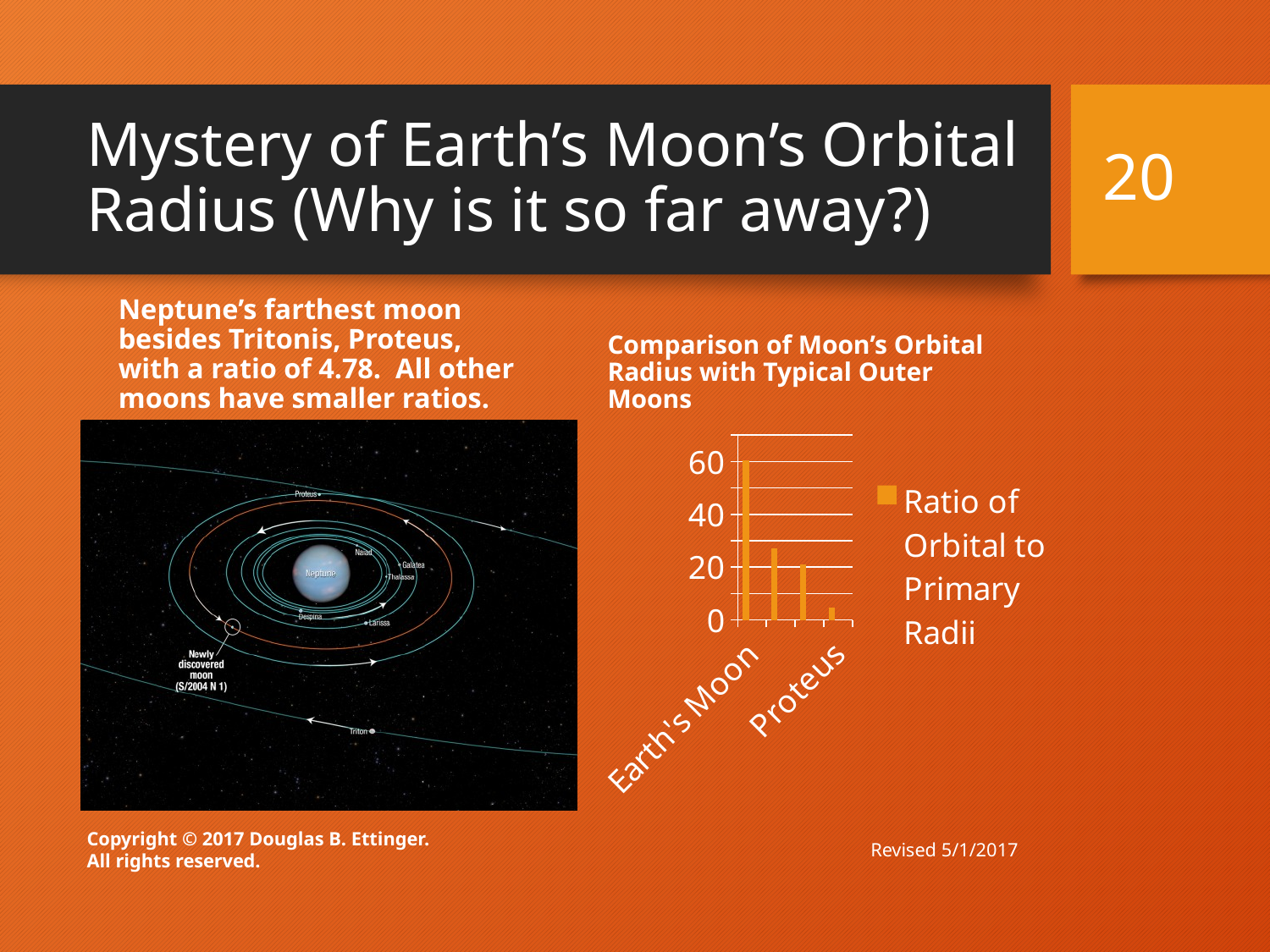
What is the name of the series shown in the chart's legend? Ratio of Orbital to Primary Radii Is the value for Proteus greater or less than 40? less Which category has the highest ratio of orbital to primary radii in the chart? Earth's Moon Do the bar values rise or fall moving from left to right along the x axis? fall How many series does the chart's legend list? 1 Is the value for Earth's Moon greater or less than 40? greater What kind of chart is shown on the slide? bar chart Which has a larger ratio of orbital to primary radii, Earth's Moon or Proteus? Earth's Moon What is the title of the chart on the slide? Comparison of Moon's Orbital Radius with Typical Outer Moons How many bars are plotted in the chart? 4